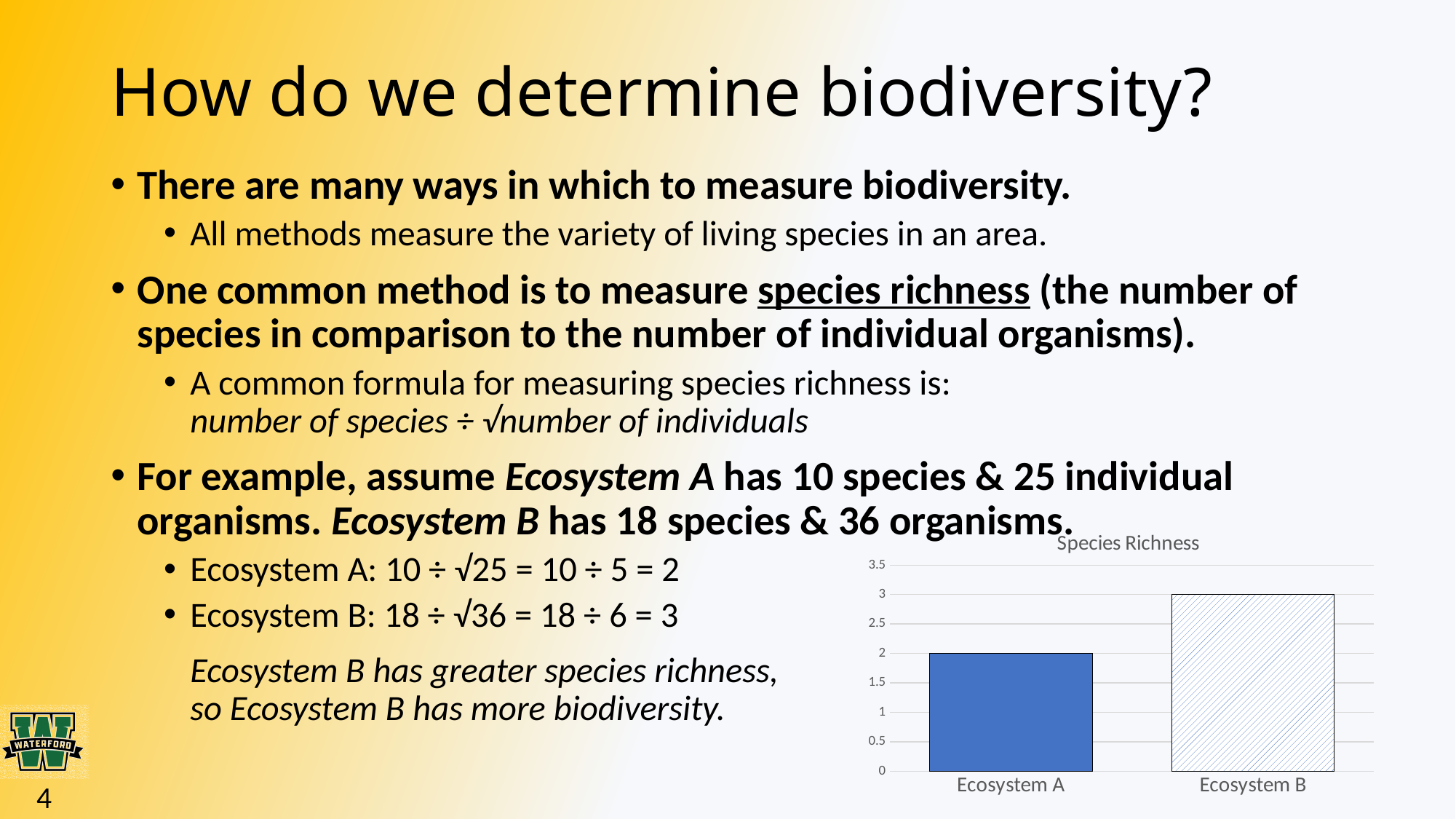
What is the title of the chart? Species Richness What is the highest value shown on the vertical axis of the chart? 3.5 What type of chart is shown on the slide? bar chart How many categories are plotted in the Species Richness chart? 2 What is the species richness value for Ecosystem A in the chart? 2 Which ecosystem has the lowest species richness in the chart? Ecosystem A Which has a larger species richness value, Ecosystem A or Ecosystem B? Ecosystem B Which ecosystem has the highest species richness in the chart? Ecosystem B What is the difference in species richness between Ecosystem B and Ecosystem A? 1 Is the value for Ecosystem A greater or less than 2.5? less What is the species richness value for Ecosystem B in the chart? 3 Is the value for Ecosystem B greater or less than 2.5? greater